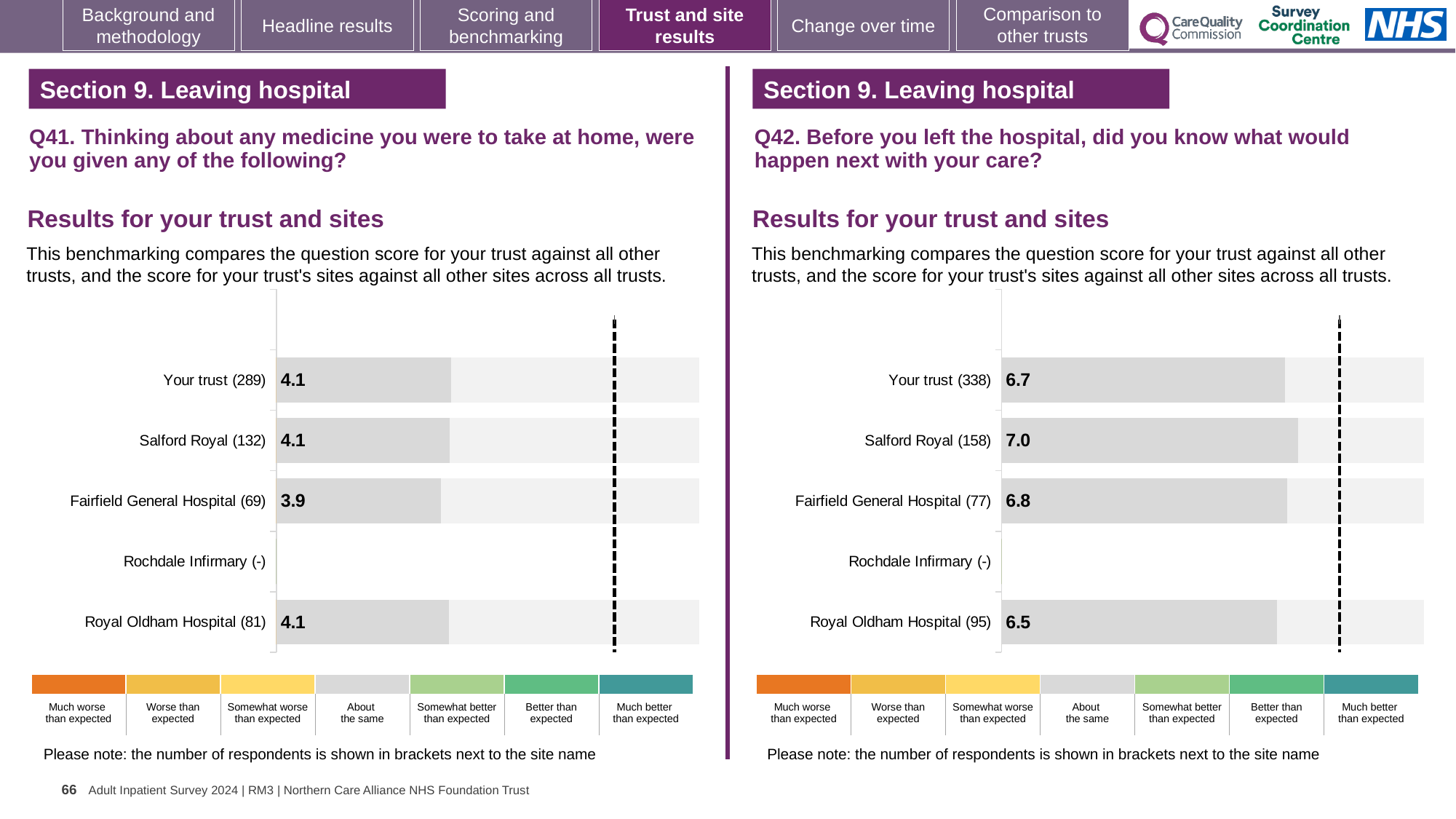
In the Q42 chart on the right, what is the difference between the scores for Salford Royal and Your trust? 0.3 In the Q41 chart on the left, which site has the lowest score? Fairfield General Hospital In the Q42 chart on the right, which site has the highest score? Salford Royal In the Q42 chart on the right, which has the larger score, Fairfield General Hospital or Royal Oldham Hospital? Fairfield General Hospital In the Q42 chart on the right, what is the score for Royal Oldham Hospital? 6.5 In the Q42 chart on the right, which site has the lowest score among those with a value shown? Royal Oldham Hospital In the Q42 chart on the right, what is the score for Salford Royal? 7.0 In the Q41 chart on the left, what is the score for Your trust? 4.1 What type of chart is used for the Q42 results on the right? Bar chart In the Q41 chart on the left, what is the score for Fairfield General Hospital? 3.9 In the Q41 chart on the left, what is the difference between the scores for Salford Royal and Fairfield General Hospital? 0.2 How many sites or categories are listed in the Q41 chart on the left? 5